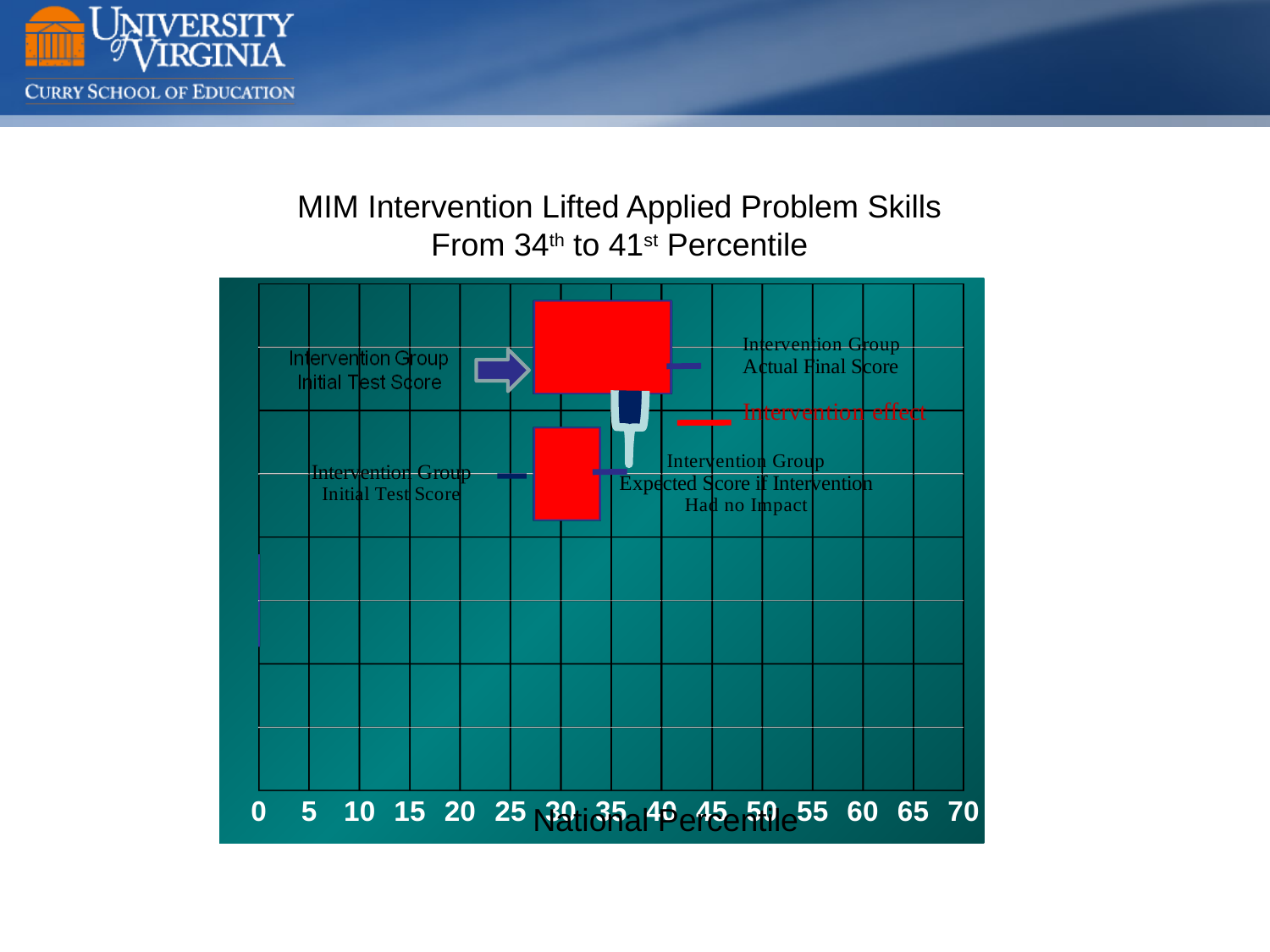
Is the Intervention Group Actual Final Score greater or less than 35 on the National Percentile axis? greater Is the Intervention Group Expected Score if Intervention Had no Impact greater or less than 40 on the National Percentile axis? less By how many percentile points did the MIM intervention lift applied problem skills, according to the title? 7 How many tick labels are shown on the National Percentile axis? 15 According to the chart title, at what percentile did the intervention group's applied problem skills start? 34th What is the highest value shown on the National Percentile axis? 70 What is the label of the x axis? National Percentile According to the chart title, at what percentile did the intervention group's applied problem skills end? 41st What kind of chart is shown on the slide? Bar chart What is the interval between consecutive tick labels on the National Percentile axis? 5 Which is larger, the intervention group's initial percentile or its final percentile? Final percentile What is the title of the chart? MIM Intervention Lifted Applied Problem Skills From 34th to 41st Percentile